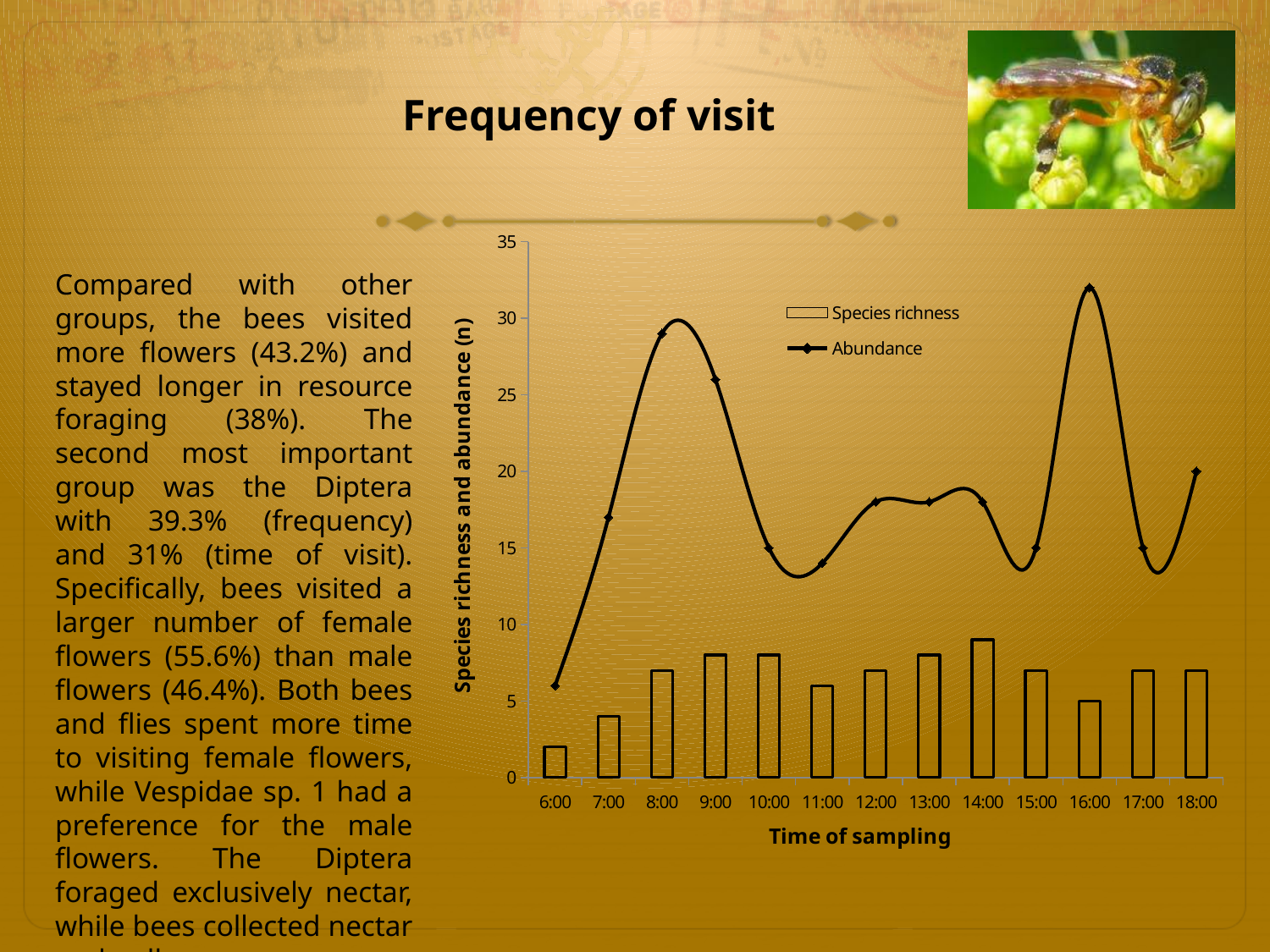
How many series does the chart legend list? 2 At which time of sampling is Abundance highest? 16:00 At which time of sampling is Species richness lowest? 6:00 What is the title of the x axis of the chart? Time of sampling At which time of sampling is Species richness highest? 14:00 Is the Abundance value at 6:00 greater or less than 10? less At which time of sampling is Abundance lowest? 6:00 Is the Abundance value at 8:00 greater or less than 25? greater Is the Abundance value at 16:00 greater or less than 30? greater How many time points are shown on the x axis of the chart? 13 What kind of chart is shown on the slide? Combined bar and line chart Which is larger, the Abundance at 8:00 or the Abundance at 10:00? 8:00